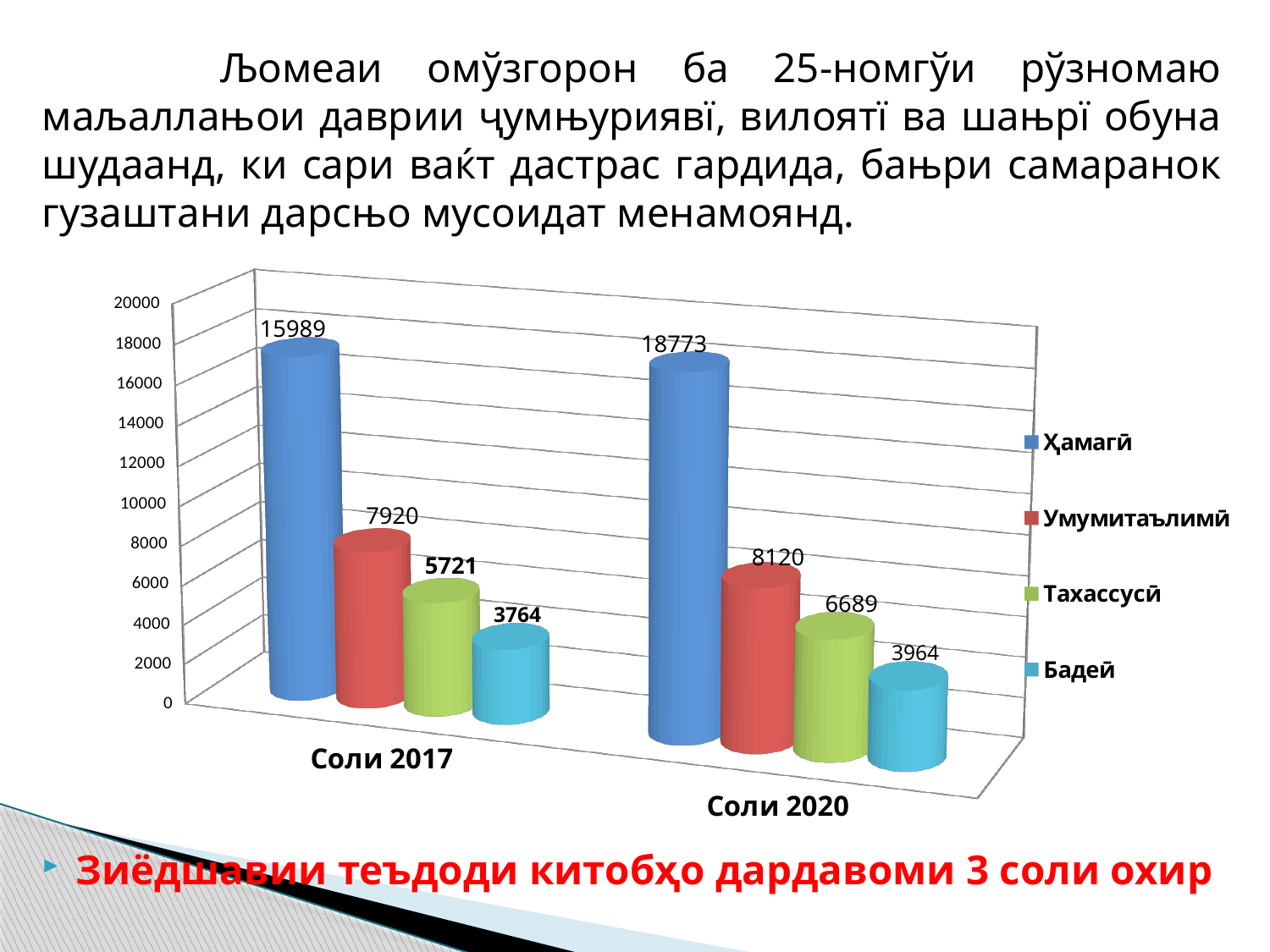
How many series does the legend list? 4 What is the value of Бадей for Соли 2017? 3764 What is the value of Ҳамагӣ for Соли 2020? 18773 Which series has the highest value for Соли 2017? Ҳамагӣ What is the value of Ҳамагӣ for Соли 2017? 15989 How many categories are shown on the x axis? 2 What is the value of Умумитаълимӣ for Соли 2020? 8120 What is the difference between the Ҳамагӣ values for Соли 2020 and Соли 2017? 2784 What is the value of Тахассусӣ for Соли 2020? 6689 What kind of chart is shown on the slide? Bar chart Which series has the lowest value for Соли 2020? Бадей Which is larger: Тахассусӣ for Соли 2017 or Тахассусӣ for Соли 2020? Соли 2020